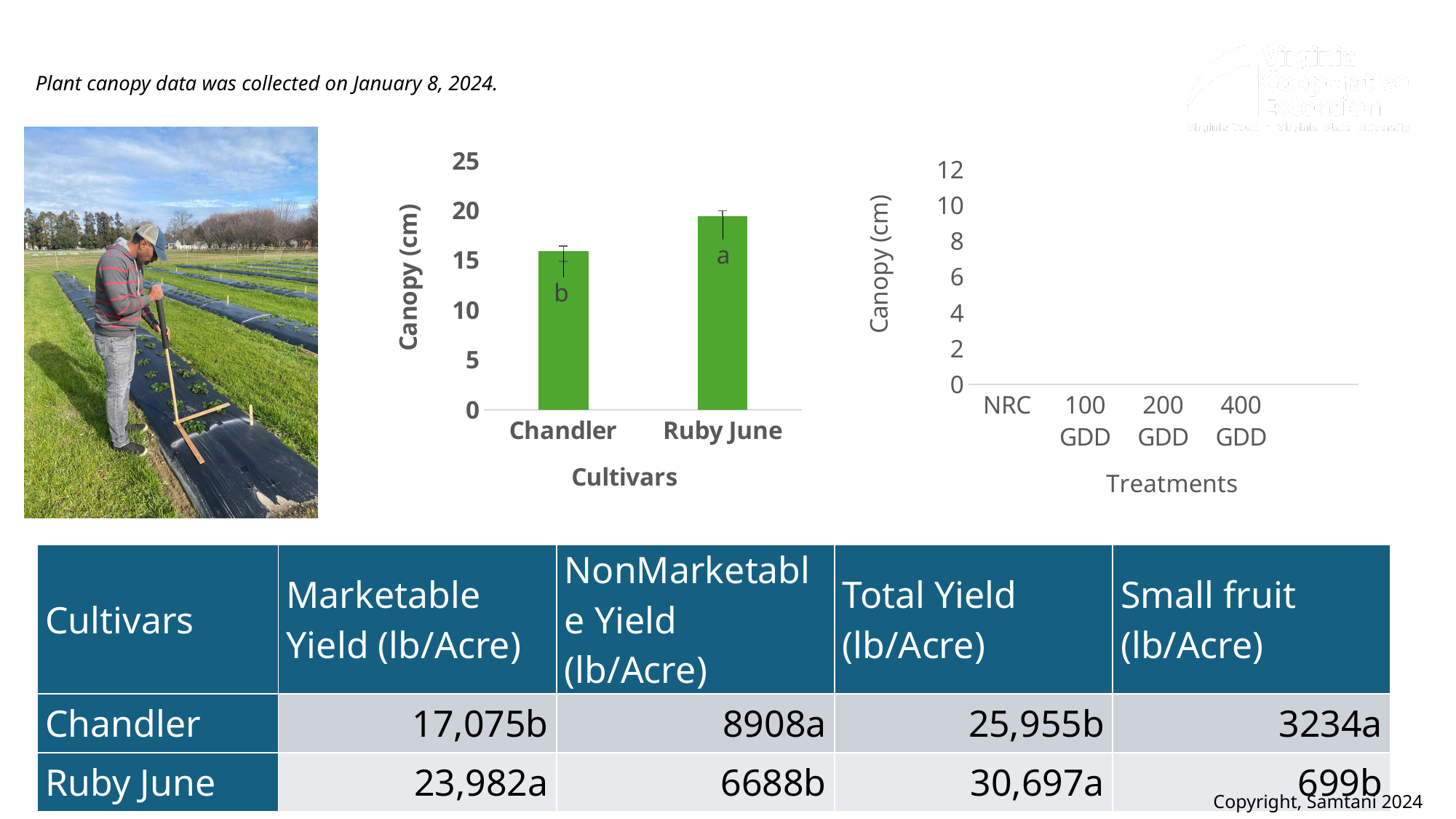
What is the x-axis title of the right chart? Treatments In the left chart, is the canopy value for Chandler greater or less than 20? less What kind of chart is the left chart showing canopy by cultivar? bar chart In the right chart, how many treatment categories are listed on the x axis? 4 In the left chart, is the canopy value for Chandler greater or less than 10? greater In the left chart, is the canopy value for Ruby June greater or less than 15? greater In the left chart, which cultivar has the highest canopy? Ruby June In the left chart, which cultivar has the lowest canopy? Chandler In the left chart, how many cultivars are plotted on the x axis? 2 What is the y-axis label of the left chart? Canopy (cm) In the left chart, which cultivar has the larger canopy, Chandler or Ruby June? Ruby June